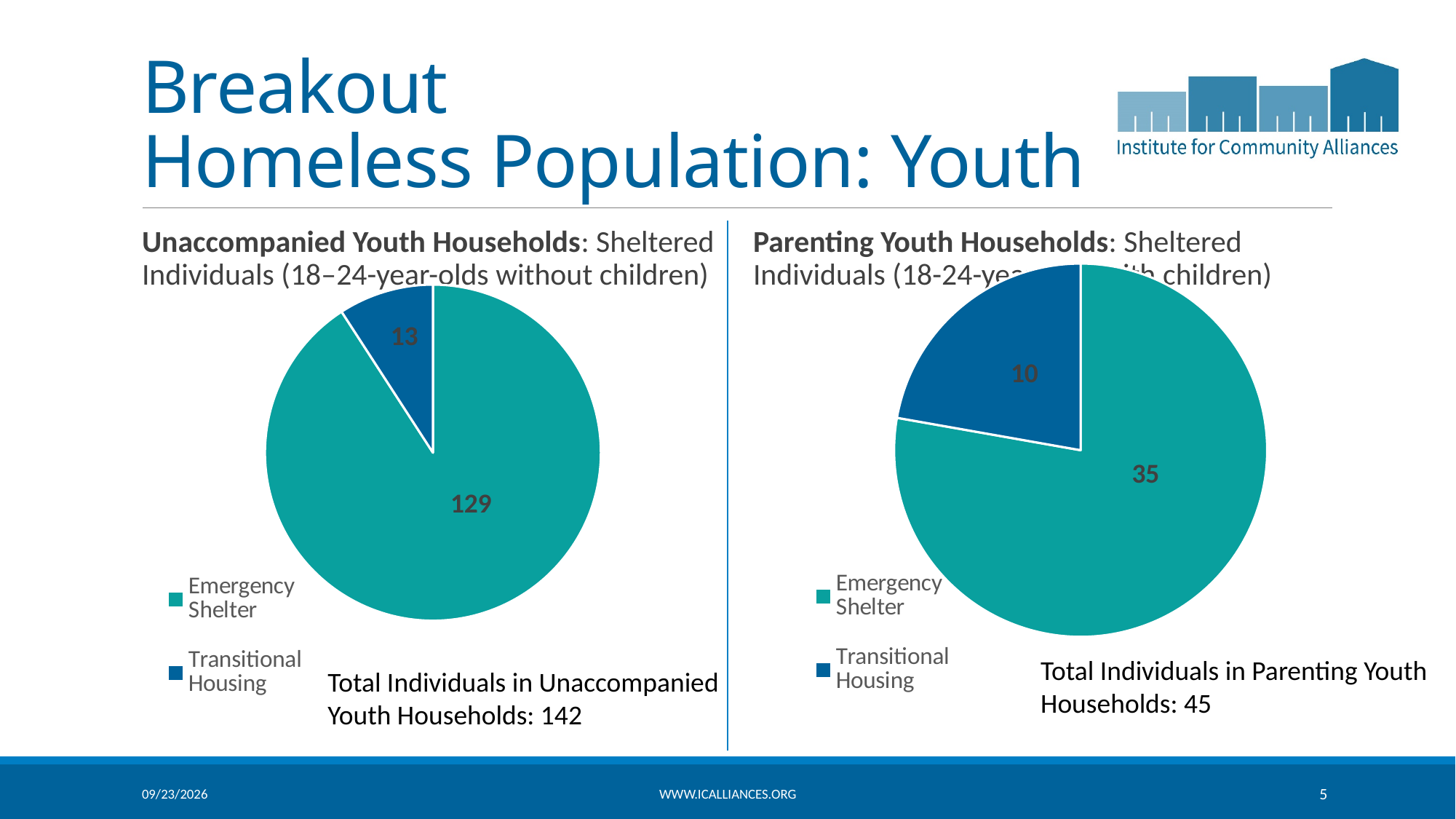
In the Unaccompanied Youth Households pie chart, what is the value for Transitional Housing? 13 In the Parenting Youth Households pie chart, what is the value for Emergency Shelter? 35 In the Unaccompanied Youth Households pie chart, what is the difference between Emergency Shelter and Transitional Housing? 116 How many categories does the legend of the Unaccompanied Youth Households pie chart list? 2 In the Parenting Youth Households pie chart, what is the value for Transitional Housing? 10 In the Unaccompanied Youth Households pie chart, what is the value for Emergency Shelter? 129 What type of chart is used for the Parenting Youth Households data? Pie chart In the Parenting Youth Households pie chart, what is the difference between Emergency Shelter and Transitional Housing? 25 Which is larger: Transitional Housing in the Unaccompanied Youth Households chart or Transitional Housing in the Parenting Youth Households chart? Unaccompanied Youth Households In the Parenting Youth Households pie chart, which category has the smallest slice? Transitional Housing What is the total of all slices in the Parenting Youth Households pie chart? 45 In the Unaccompanied Youth Households pie chart, which category has the largest slice? Emergency Shelter